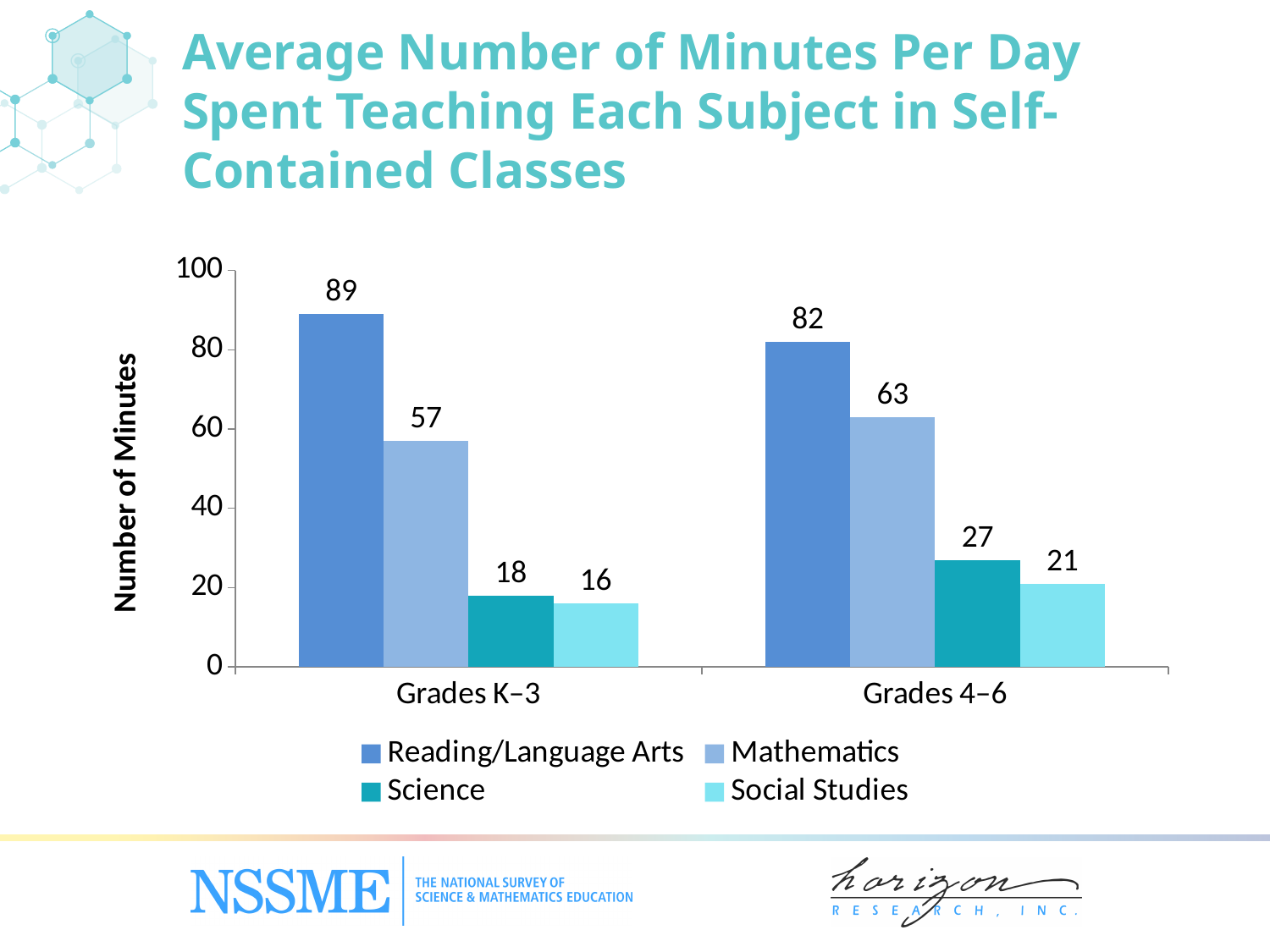
What is the value for Social Studies in Grades K–3? 16 What is the average number of minutes per day spent teaching Science in Grades 4–6? 27 What is the label of the vertical axis? Number of Minutes Which is larger: Science in Grades 4–6 or Social Studies in Grades 4–6? Science in Grades 4–6 What kind of chart is shown on the slide? Bar chart Which subject has the highest average number of minutes per day in Grades 4–6? Reading/Language Arts How many series does the legend list? 4 Which subject has the lowest average number of minutes per day in Grades K–3? Social Studies Is the value for Mathematics in Grades 4–6 greater or less than 60? greater What is the difference between the minutes spent on Mathematics in Grades 4–6 and in Grades K–3? 6 What is the difference between Reading/Language Arts and Science in Grades K–3? 71 What is the average number of minutes per day spent teaching Reading/Language Arts in Grades K–3? 89